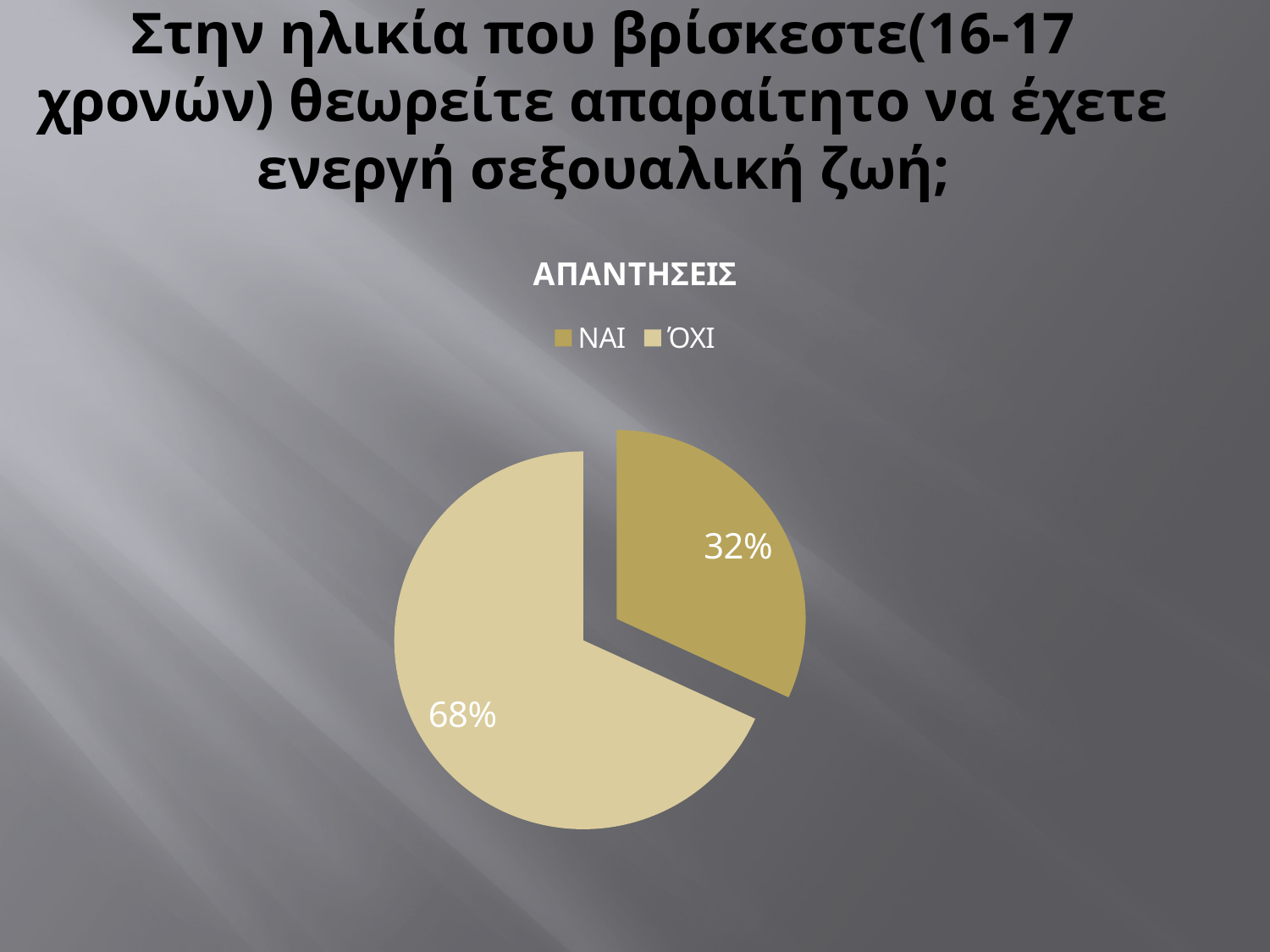
What share of the pie does ΌΧΙ represent? 68% What is the title of the chart? ΑΠΑΝΤΗΣΕΙΣ Which category has the smallest slice of the pie? ΝΑΙ How many categories does the pie chart show? 2 Which category has the largest slice of the pie? ΌΧΙ Which slice is pulled out (exploded) from the pie? ΝΑΙ What kind of chart is shown on the slide? pie chart How many entries does the legend list? 2 What share of the pie does ΝΑΙ represent? 32% Which is larger, the ΝΑΙ slice or the ΌΧΙ slice? ΌΧΙ What is the difference in percentage points between the ΌΧΙ and ΝΑΙ slices? 36